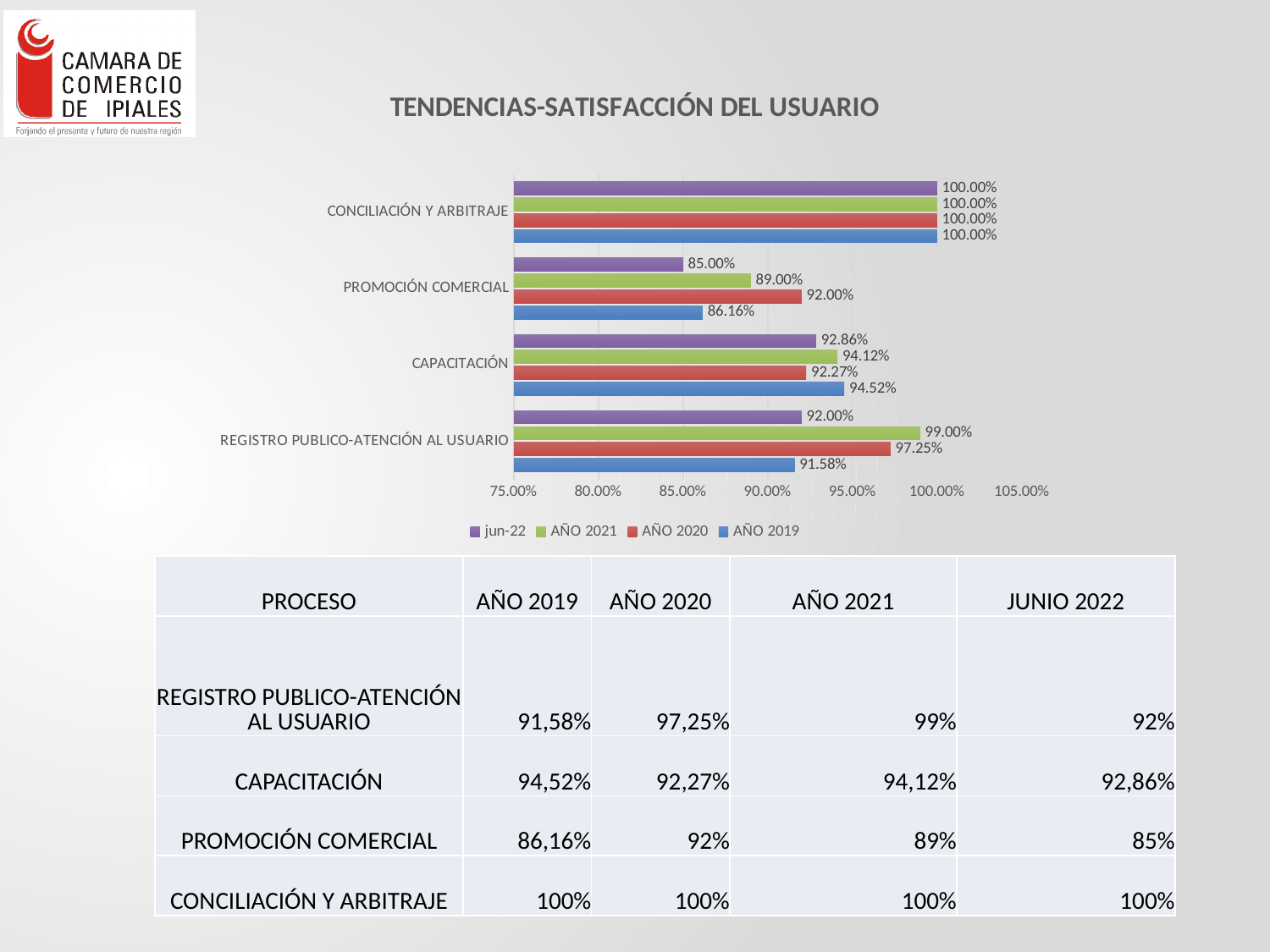
For CAPACITACIÓN, which is larger: the AÑO 2019 value or the AÑO 2020 value? AÑO 2019 What is the value for PROMOCIÓN COMERCIAL in the AÑO 2020 series? 92.00% How many categories are shown on the chart? 4 Which category has the highest AÑO 2021 value? CONCILIACIÓN Y ARBITRAJE How many series does the legend list? 4 What is the AÑO 2021 value for REGISTRO PUBLICO-ATENCIÓN AL USUARIO? 99.00% What is the difference between the AÑO 2021 and jun-22 values for REGISTRO PUBLICO-ATENCIÓN AL USUARIO? 7.00% What is the AÑO 2019 value for PROMOCIÓN COMERCIAL? 86.16% Which category has the lowest jun-22 value? PROMOCIÓN COMERCIAL Is the AÑO 2019 value for REGISTRO PUBLICO-ATENCIÓN AL USUARIO greater or less than 95.00%? less What kind of chart is shown on the slide? bar chart What is the jun-22 value for CAPACITACIÓN? 92.86%